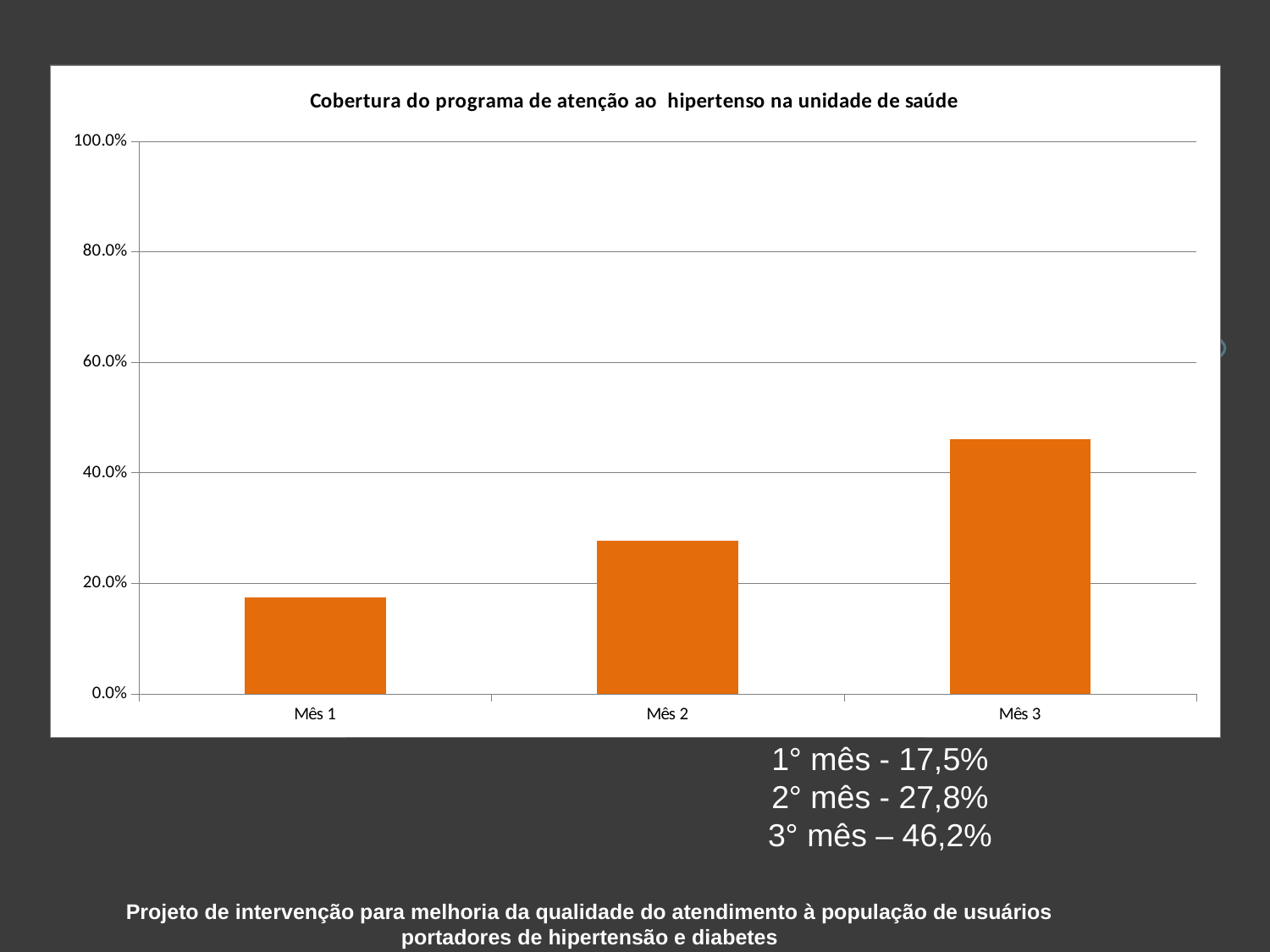
Do the coverage values rise or fall from Mês 1 to Mês 3? rise How many categories (months) are plotted in the chart? 3 Is the value for Mês 2 greater or less than 40.0%? less Which is larger, the value for Mês 2 or the value for Mês 1? Mês 2 What is the title of the chart? Cobertura do programa de atenção ao hipertenso na unidade de saúde Is the value for Mês 1 greater or less than 20.0%? less Is the value for Mês 3 greater or less than 40.0%? greater According to the text on the slide, what is the coverage value for the 3° mês? 46,2% According to the text on the slide, what is the coverage value for the 1° mês? 17,5% Which month has the highest coverage value? Mês 3 What kind of chart is shown on the slide? bar chart Which month has the lowest coverage value? Mês 1